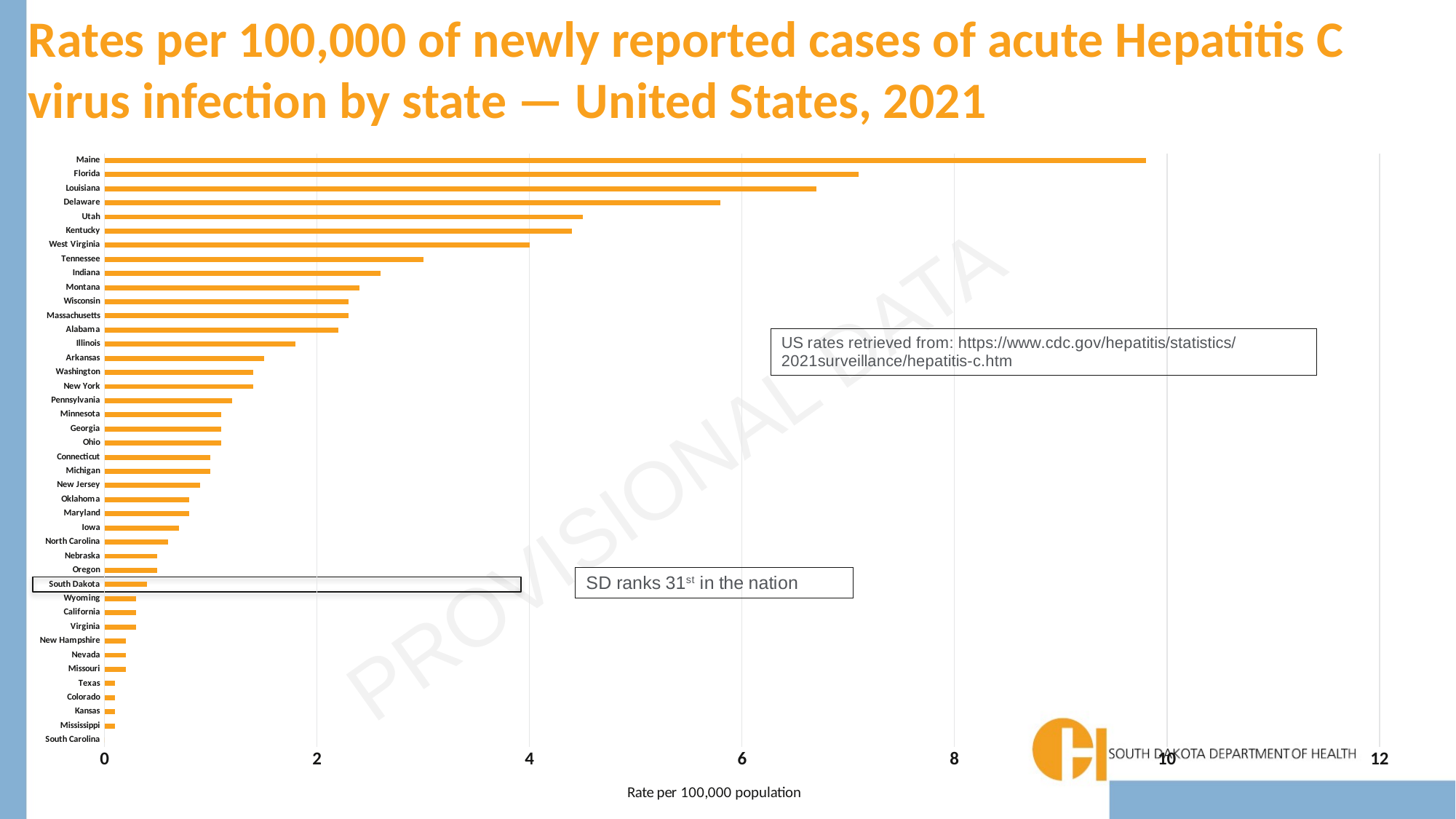
Is the value for South Dakota greater or less than 2? less What kind of chart is shown on the slide? bar chart Is the value for Maine greater or less than 8? greater What is the title of the horizontal axis? Rate per 100,000 population Do the bar values increase or decrease going from the top of the chart to the bottom? decrease How many states are listed on the chart? 42 Which state is listed at the bottom of the chart with the lowest rate? South Carolina Is the value for Florida greater or less than 6? greater Which state has the highest rate on the chart? Maine Which has a higher rate, Utah or Illinois? Utah Which has a higher rate, Maine or Florida? Maine